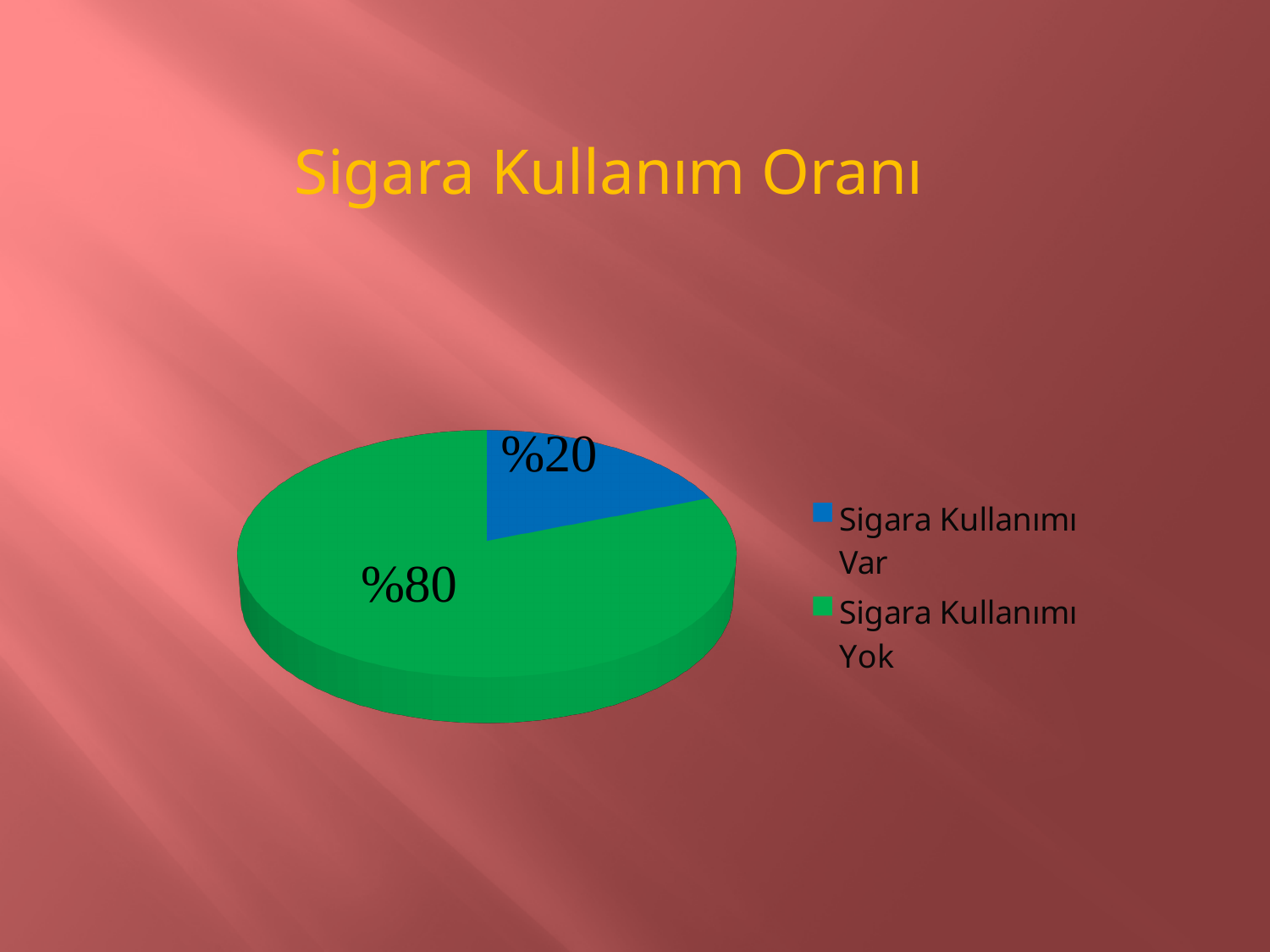
How many entries does the legend list? 2 Which category has the largest slice of the pie? Sigara Kullanımı Yok Which is larger: the value for "Sigara Kullanımı Var" or the value for "Sigara Kullanımı Yok"? Sigara Kullanımı Yok Which category has the smallest slice of the pie? Sigara Kullanımı Var How many slices does the pie chart have? 2 What is the value shown for "Sigara Kullanımı Var"? %20 What is the title of the chart? Sigara Kullanım Oranı What is the value shown for "Sigara Kullanımı Yok"? %80 What share of the pie does "Sigara Kullanımı Var" represent? %20 What colour is the slice for "Sigara Kullanımı Yok"? Green What is the difference between the values for "Sigara Kullanımı Yok" and "Sigara Kullanımı Var"? %60 What type of chart is shown on the slide? Pie chart